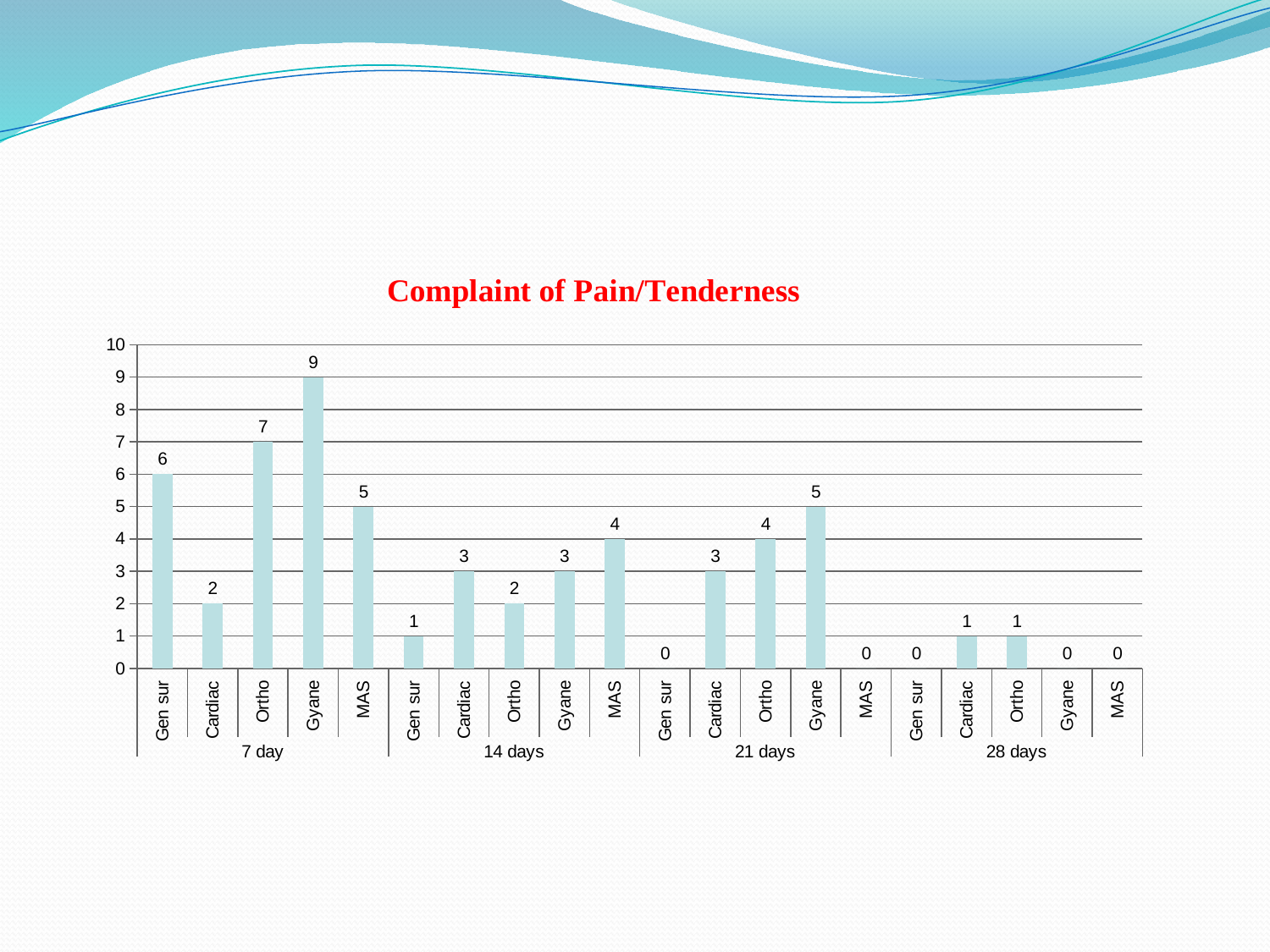
How many bars (category entries) are plotted on the chart? 20 What is the total of the five values in the 21 days group? 12 Which is larger: Ortho in the 7 day group or Gyane in the 21 days group? Ortho in the 7 day group What kind of chart is shown? Bar chart What is the value for Cardiac in the 28 days group? 1 What is the value for Gyane in the 7 day group? 9 What is the title of the chart? Complaint of Pain/Tenderness Within the 14 days group, which category has the lowest value? Gen sur What is the value for MAS in the 14 days group? 4 Which bar has the highest value on the chart? Gyane (7 day) What is the difference between Gyane and Cardiac in the 7 day group? 7 What is the value for Ortho in the 21 days group? 4